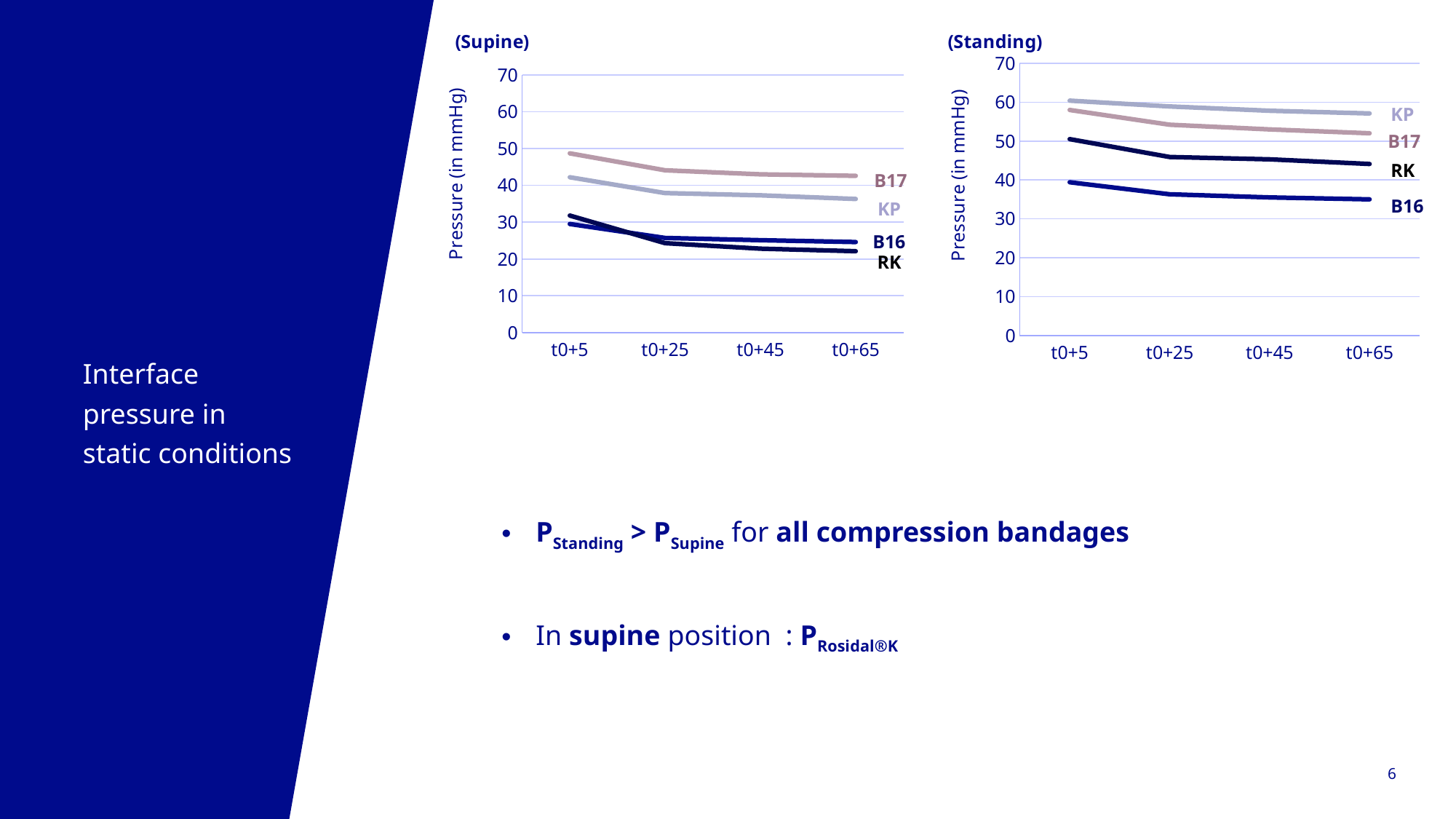
In the (Supine) chart, does the pressure for KP rise or fall from t0+5 to t0+65? fall In the (Supine) chart, is the value for B17 at t0+5 greater or less than 40? greater How many series are labelled on the (Supine) chart? 4 In the (Supine) chart, which series has the lowest pressure at t0+65? RK In the (Supine) chart, which series has the highest pressure at t0+65? B17 In the (Standing) chart, is the value for B16 at t0+65 greater or less than 40? less How many time points are shown on the x axis of the (Standing) chart? 4 What kind of chart is the (Supine) chart? line chart In the (Standing) chart, which series has the highest pressure at t0+65? KP In the (Standing) chart, which series has the lowest pressure at t0+5? B16 What is the y-axis label of the (Standing) chart? Pressure (in mmHg) In the (Standing) chart, which is larger at t0+65: the value for RK or the value for B16? RK